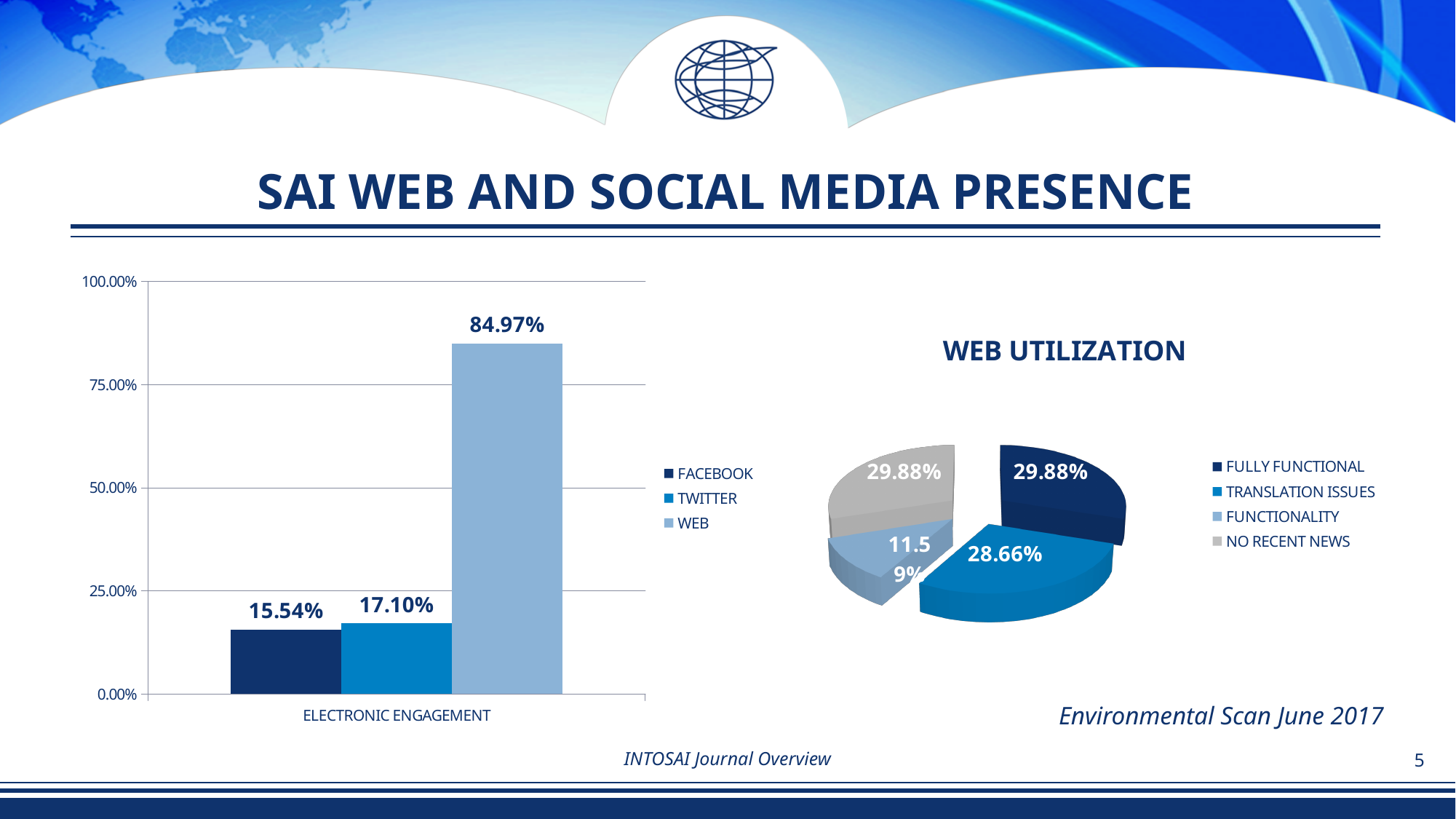
In the WEB UTILIZATION chart, how many categories does the legend list? 4 In the bar chart on the left, what is the difference between the WEB value and the TWITTER value? 67.87% In the bar chart on the left, which series has the lowest value? FACEBOOK What kind of chart is the WEB UTILIZATION chart? Pie chart In the WEB UTILIZATION chart, which category has the smallest slice? FUNCTIONALITY In the WEB UTILIZATION chart, what is the share for TRANSLATION ISSUES? 28.66% In the bar chart on the left, which series has the highest value? WEB What kind of chart is the chart on the left? Bar chart In the bar chart on the left, how many series does the legend list? 3 In the bar chart on the left, what is the value for TWITTER? 17.10% In the bar chart on the left, what is the value for FACEBOOK? 15.54% In the bar chart on the left, what is the value for WEB? 84.97%